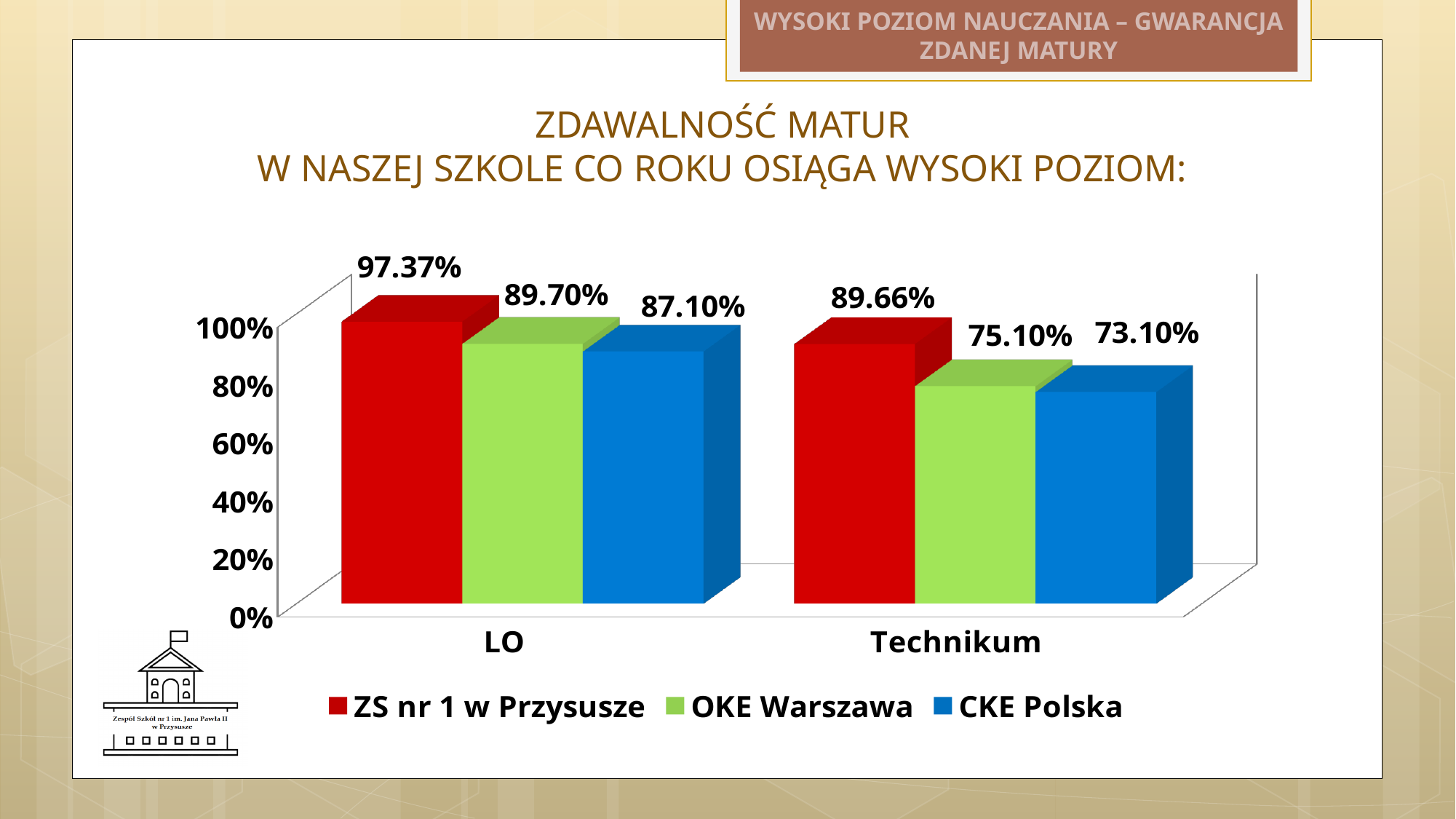
How many series does the legend list? 3 How many categories are shown on the x axis? 2 What is the value for OKE Warszawa in the Technikum category? 75.10% Which colour represents CKE Polska in the chart? Blue Which series has the highest value in the Technikum category? ZS nr 1 w Przysusze What kind of chart is shown on the slide? Bar chart What is the value for CKE Polska in the Technikum category? 73.10% Which series has the lowest value in the LO category? CKE Polska What is the value for ZS nr 1 w Przysusze in the LO category? 97.37% What is the difference between the ZS nr 1 w Przysusze value and the CKE Polska value in the LO category? 10.27% Which is larger: the ZS nr 1 w Przysusze value for Technikum or the OKE Warszawa value for LO? OKE Warszawa value for LO What is the value for OKE Warszawa in the LO category? 89.70%